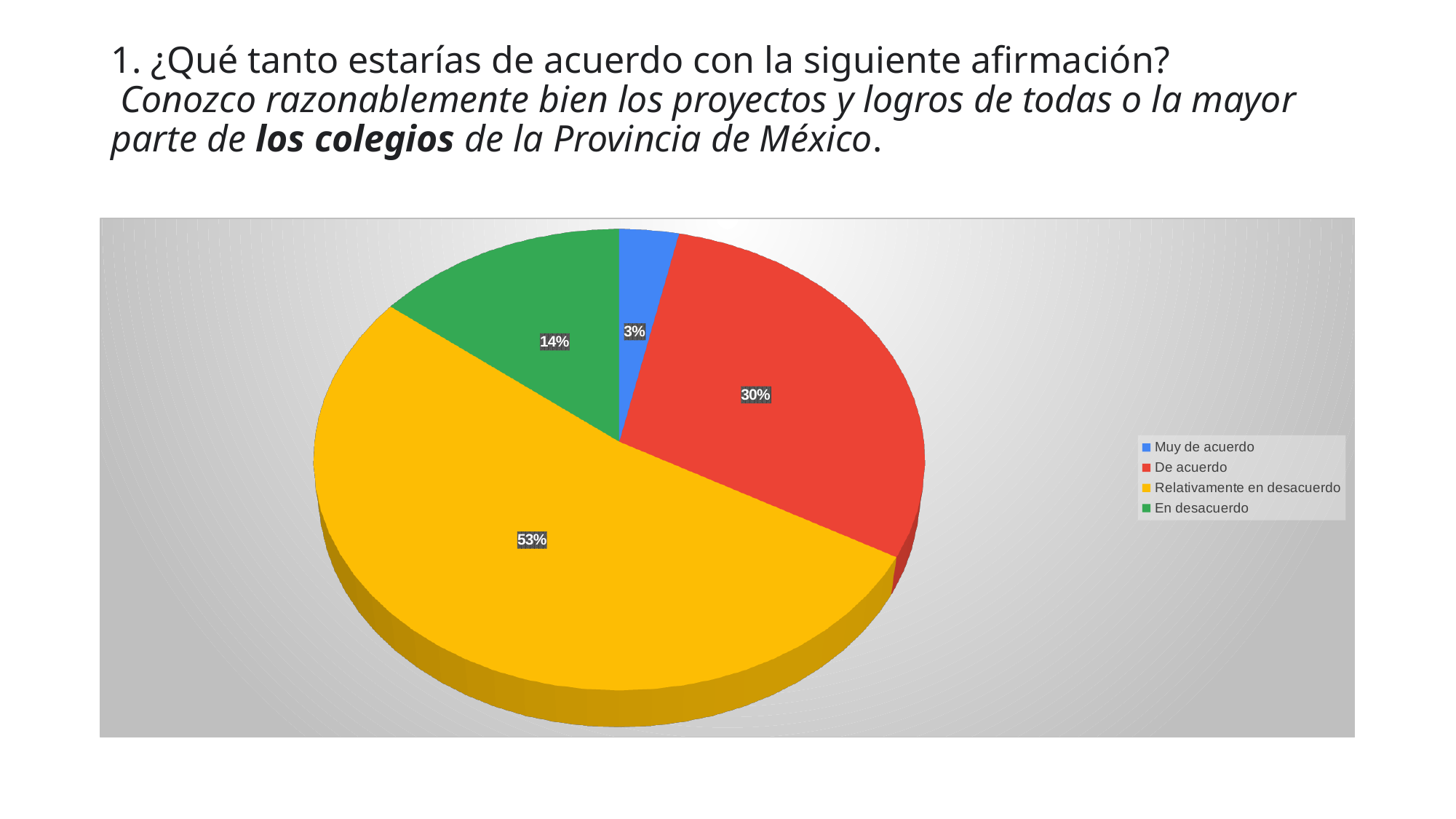
What percentage of respondents answered "En desacuerdo"? 14% What percentage of respondents answered "De acuerdo"? 30% What colour is the slice for "En desacuerdo"? Green What kind of chart is shown on the slide? Pie chart Which is larger: the share for "De acuerdo" or the share for "En desacuerdo"? De acuerdo What is the difference in percentage points between "Relativamente en desacuerdo" and "De acuerdo"? 23 Which response category has the largest share of the pie? Relativamente en desacuerdo What percentage of respondents answered "Muy de acuerdo"? 3% What percentage of respondents answered "Relativamente en desacuerdo"? 53% How many categories does the legend list? 4 What colour is the slice for "Relativamente en desacuerdo"? Yellow Which response category has the smallest share of the pie? Muy de acuerdo